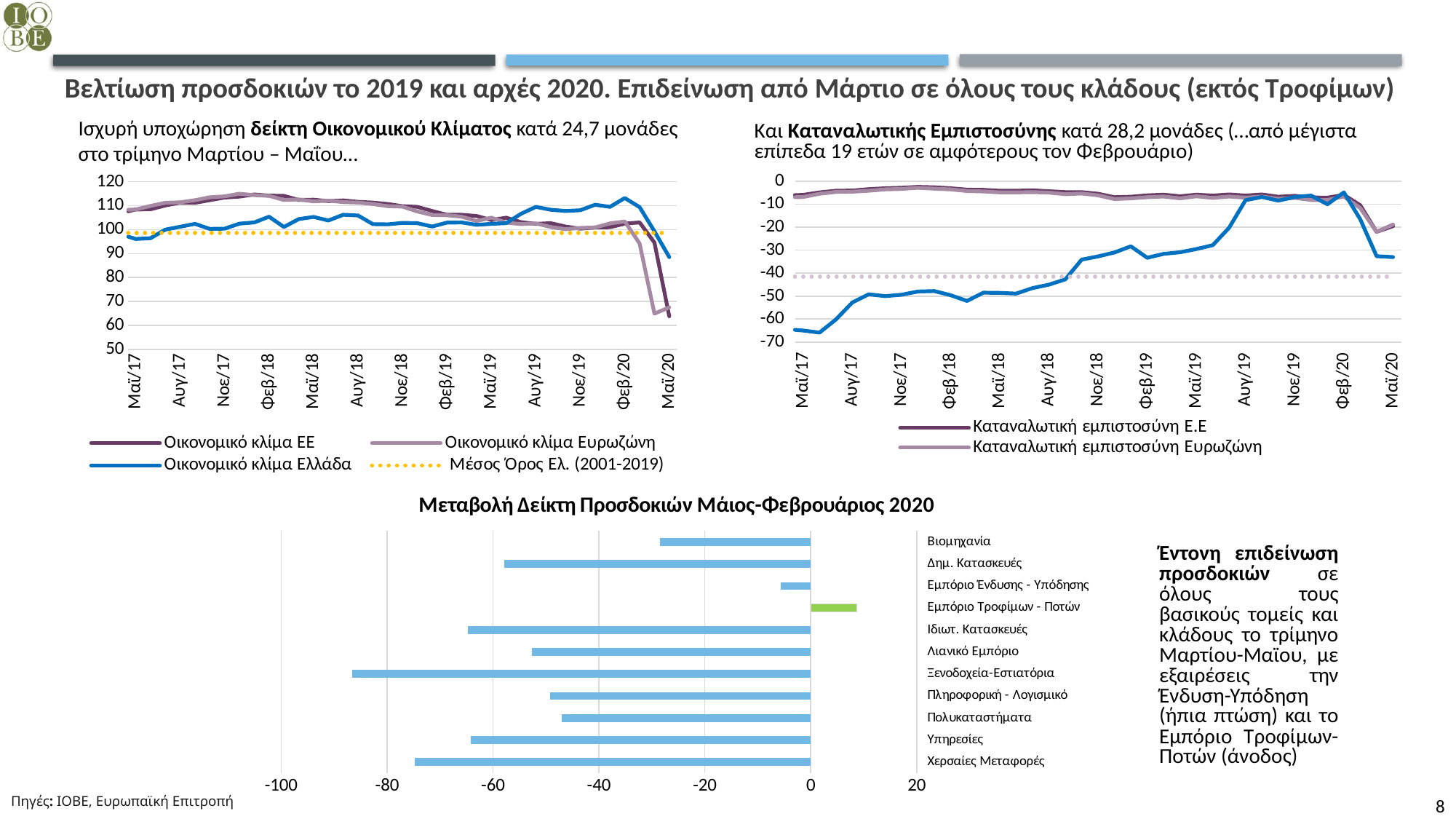
In the bottom chart 'Μεταβολή Δείκτη Προσδοκιών Μάιος-Φεβρουάριος 2020', is the value for Ξενοδοχεία-Εστιατόρια greater or less than -80? less In the bottom chart 'Μεταβολή Δείκτη Προσδοκιών Μάιος-Φεβρουάριος 2020', which category is shown with a green bar? Εμπόριο Τροφίμων - Ποτών In the top-left chart, is the value of Οικονομικό κλίμα Ελλάδα at Μαϊ/20 greater or less than 100? less How many series does the legend of the top-right chart (Καταναλωτική εμπιστοσύνη) list? 2 In the bottom chart 'Μεταβολή Δείκτη Προσδοκιών Μάιος-Φεβρουάριος 2020', is the value for Βιομηχανία greater or less than -20? less What kind of chart is the top-left chart showing Οικονομικό κλίμα? line chart What kind of chart is the bottom chart titled 'Μεταβολή Δείκτη Προσδοκιών Μάιος-Φεβρουάριος 2020'? bar chart In the bottom chart 'Μεταβολή Δείκτη Προσδοκιών Μάιος-Φεβρουάριος 2020', how many categories are plotted? 11 In the bottom chart 'Μεταβολή Δείκτη Προσδοκιών Μάιος-Φεβρουάριος 2020', which is larger: the value for Δημ. Κατασκευές or the value for Εμπόριο Ένδυσης - Υπόδησης? Εμπόριο Ένδυσης - Υπόδησης In the bottom chart 'Μεταβολή Δείκτη Προσδοκιών Μάιος-Φεβρουάριος 2020', which category has the highest value? Εμπόριο Τροφίμων - Ποτών How many series does the legend of the top-left chart (Οικονομικό κλίμα) list? 4 In the bottom chart 'Μεταβολή Δείκτη Προσδοκιών Μάιος-Φεβρουάριος 2020', which category has the lowest value? Ξενοδοχεία-Εστιατόρια